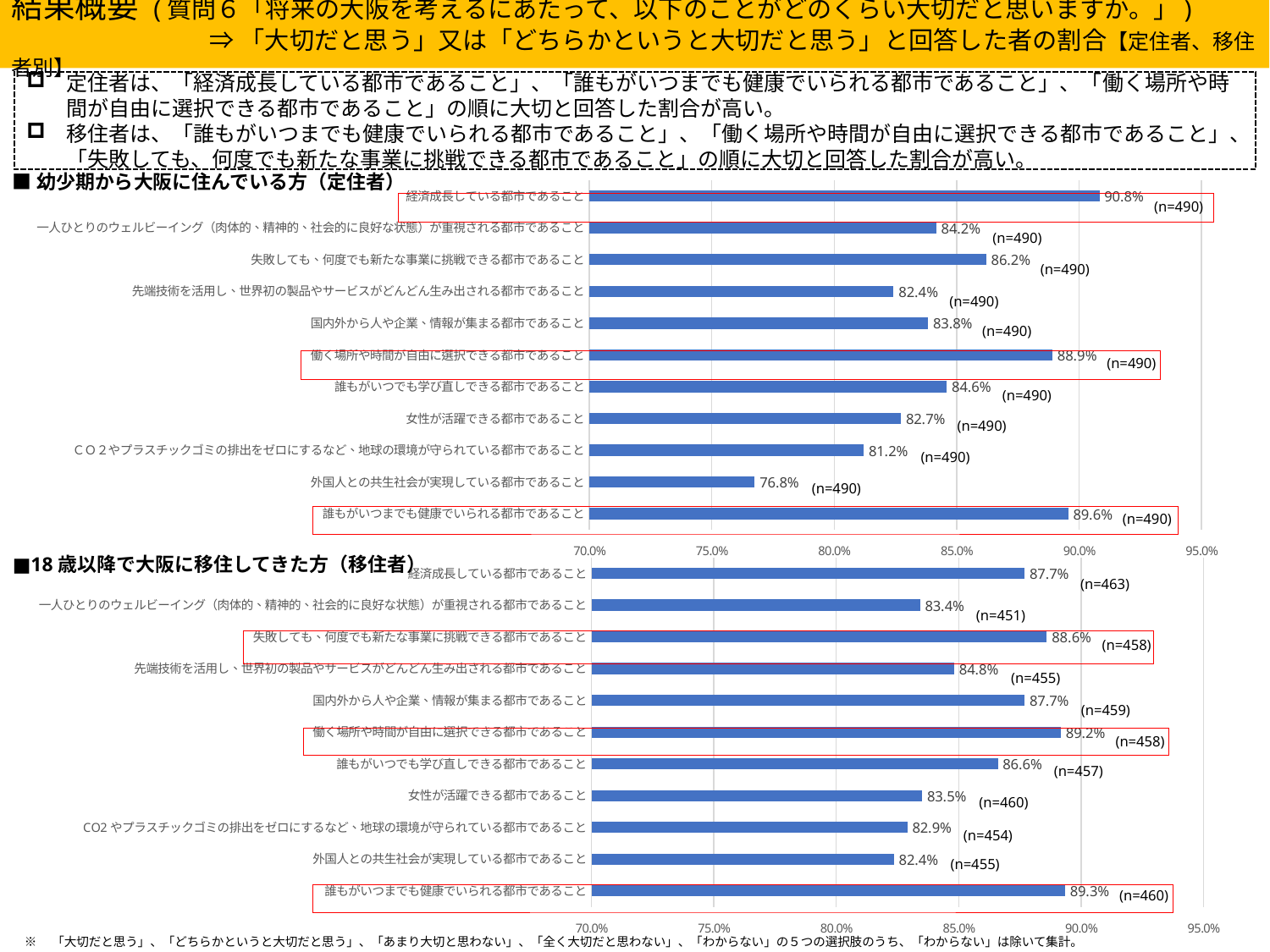
In the bottom chart (移住者), which category has the lowest value? 外国人との共生社会が実現している都市であること In the top chart (定住者), which category has the lowest value? 外国人との共生社会が実現している都市であること In the bottom chart (移住者), what is the value for 誰もがいつまでも健康でいられる都市であること? 89.3% In the bottom chart (移住者), what is the difference between 働く場所や時間が自由に選択できる都市であること and CO2やプラスチックゴミの排出をゼロにするなど、地球の環境が守られている都市であること? 6.3% In the top chart (定住者), what is the value for 経済成長している都市であること? 90.8% In the top chart (定住者), what is the difference between 経済成長している都市であること and 外国人との共生社会が実現している都市であること? 14.0% What type of chart is the bottom chart (移住者)? Bar chart In the bottom chart (移住者), which is larger: 失敗しても、何度でも新たな事業に挑戦できる都市であること or 女性が活躍できる都市であること? 失敗しても、何度でも新たな事業に挑戦できる都市であること How many categories are plotted in the top chart (定住者)? 11 In the bottom chart (移住者), what is the sample size (n) shown for 一人ひとりのウェルビーイングが重視される都市であること? n=451 In the top chart (定住者), which category has the highest value? 経済成長している都市であること In the top chart (定住者), is the value for 外国人との共生社会が実現している都市であること greater or less than 80.0%? less